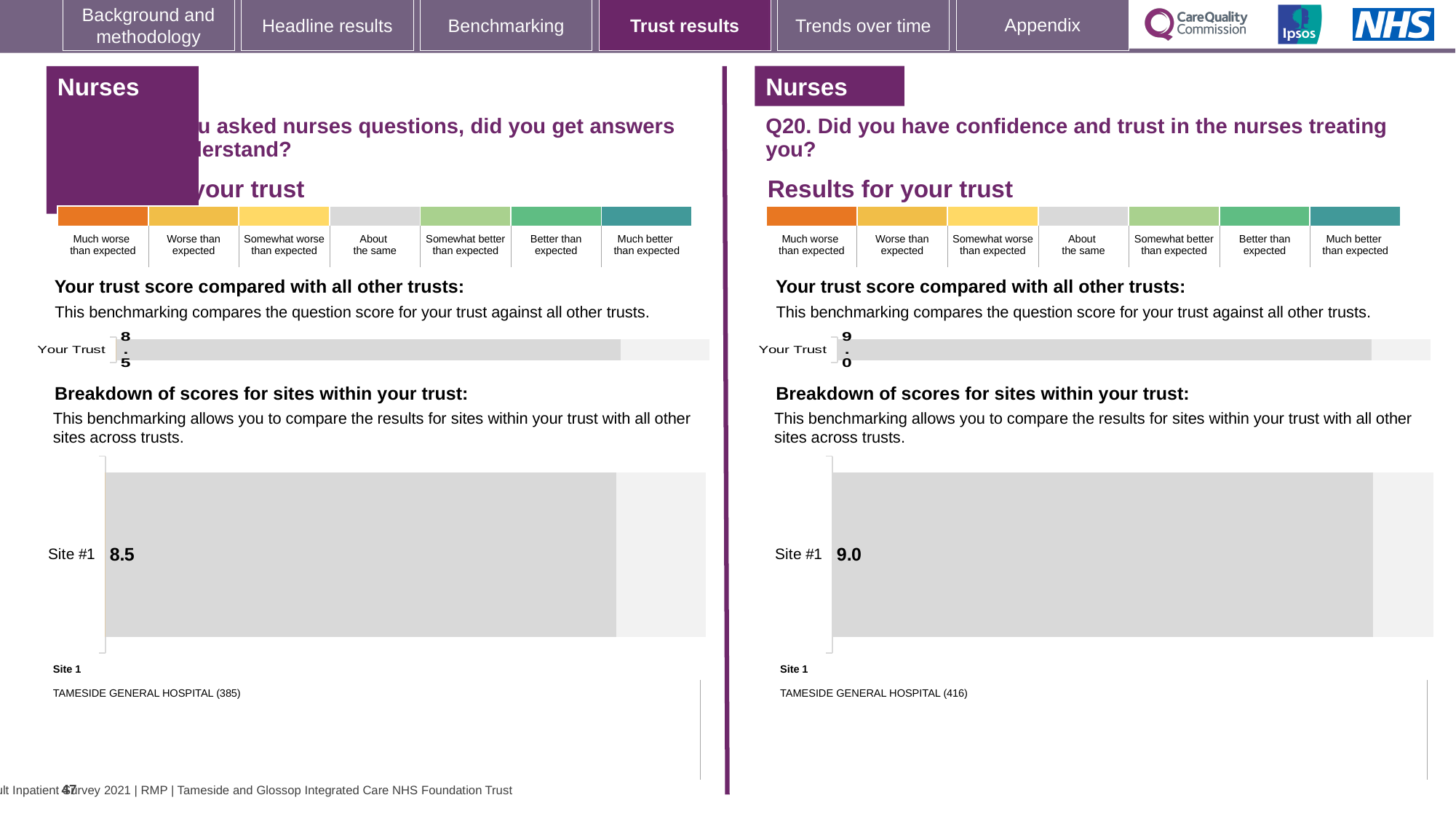
What type of chart is used for the 'Breakdown of scores for sites within your trust' on the right half of the slide (Q20)? Bar chart Which site name is listed as Site 1 below the breakdown chart on the left half of the slide? TAMESIDE GENERAL HOSPITAL (385) Which site name is listed as Site 1 below the breakdown chart on the right half of the slide (Q20)? TAMESIDE GENERAL HOSPITAL (416) On the right half of the slide (Q20), what is the score shown for Your Trust in the 'Your trust score compared with all other trusts' chart? 9.0 On the right half of the slide (Q20), what score is shown for Site #1 in the 'Breakdown of scores for sites within your trust' chart? 9.0 On the left half of the slide, what score is shown for Site #1 in the 'Breakdown of scores for sites within your trust' chart? 8.5 How many sites are plotted in the 'Breakdown of scores for sites within your trust' chart on the right half of the slide (Q20)? 1 What type of chart is used to show the Your Trust score on the left half of the slide? Bar chart How many sites are plotted in the 'Breakdown of scores for sites within your trust' chart on the left half of the slide? 1 What is the difference between the Your Trust score on the right half of the slide (Q20) and the Your Trust score on the left half? 0.5 On the left half of the slide, what is the score shown for Your Trust in the 'Your trust score compared with all other trusts' chart? 8.5 Which is larger: the Site #1 score in the left-hand breakdown chart or the Site #1 score in the right-hand (Q20) breakdown chart? The right-hand (Q20) chart